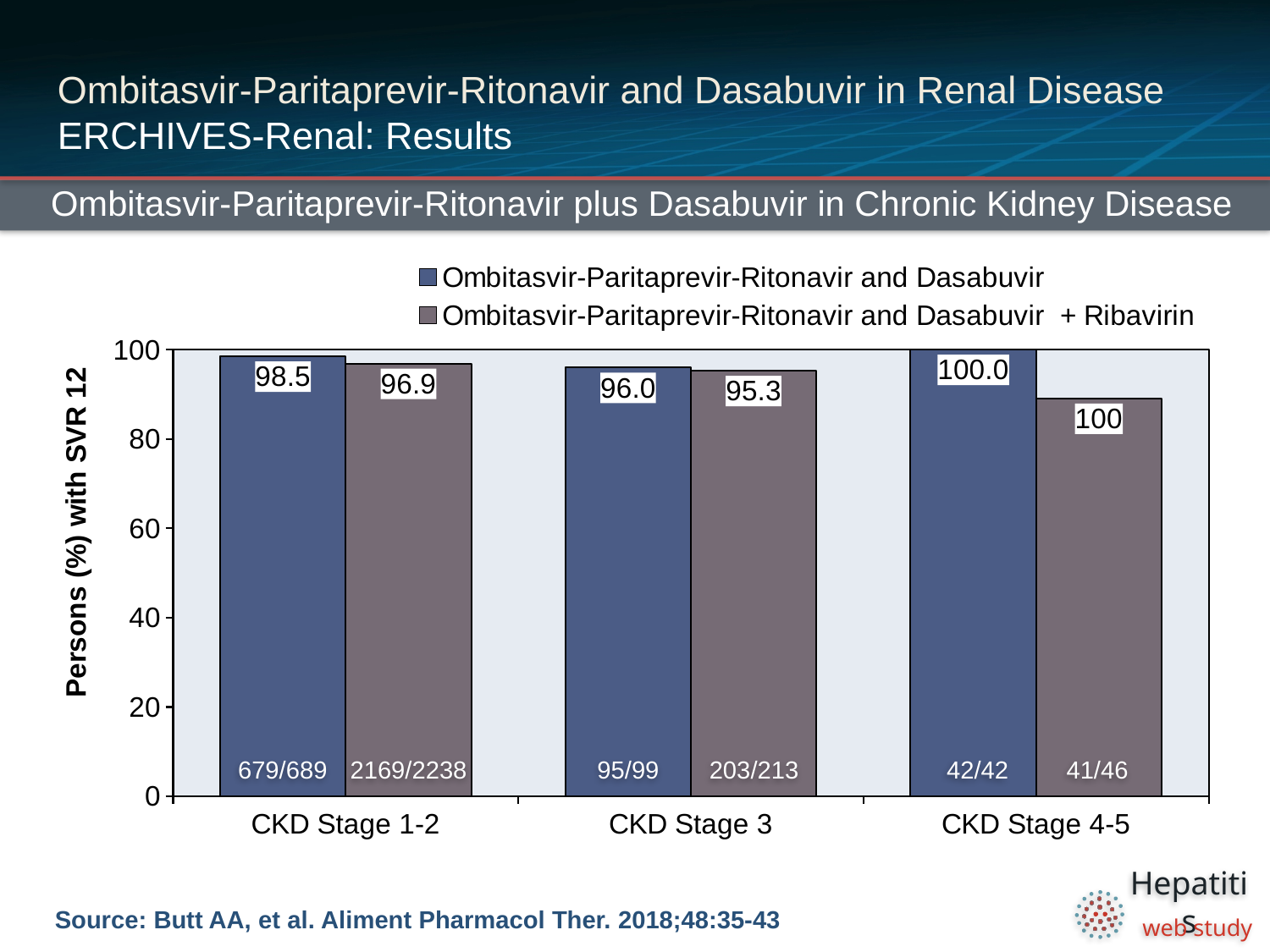
What fraction of persons is shown for Ombitasvir-Paritaprevir-Ritonavir and Dasabuvir + Ribavirin in CKD Stage 4-5? 41/46 In which CKD stage is the SVR 12 rate for Ombitasvir-Paritaprevir-Ritonavir and Dasabuvir (without ribavirin) lowest? CKD Stage 3 What is the label of the y axis? Persons (%) with SVR 12 What is the SVR 12 rate for Ombitasvir-Paritaprevir-Ritonavir and Dasabuvir in CKD Stage 1-2? 98.5 What is the difference between the SVR 12 rates of the two regimens in CKD Stage 1-2? 1.6 How many series does the legend list? 2 In which CKD stage is the SVR 12 rate for Ombitasvir-Paritaprevir-Ritonavir and Dasabuvir (without ribavirin) highest? CKD Stage 4-5 How many CKD stage categories are shown on the x axis? 3 What is the SVR 12 rate for Ombitasvir-Paritaprevir-Ritonavir and Dasabuvir + Ribavirin in CKD Stage 3? 95.3 For Ombitasvir-Paritaprevir-Ritonavir and Dasabuvir, is the SVR 12 rate higher in CKD Stage 1-2 or CKD Stage 3? CKD Stage 1-2 What kind of chart is shown on the slide? Bar chart What fraction of persons is shown for Ombitasvir-Paritaprevir-Ritonavir and Dasabuvir + Ribavirin in CKD Stage 1-2? 2169/2238